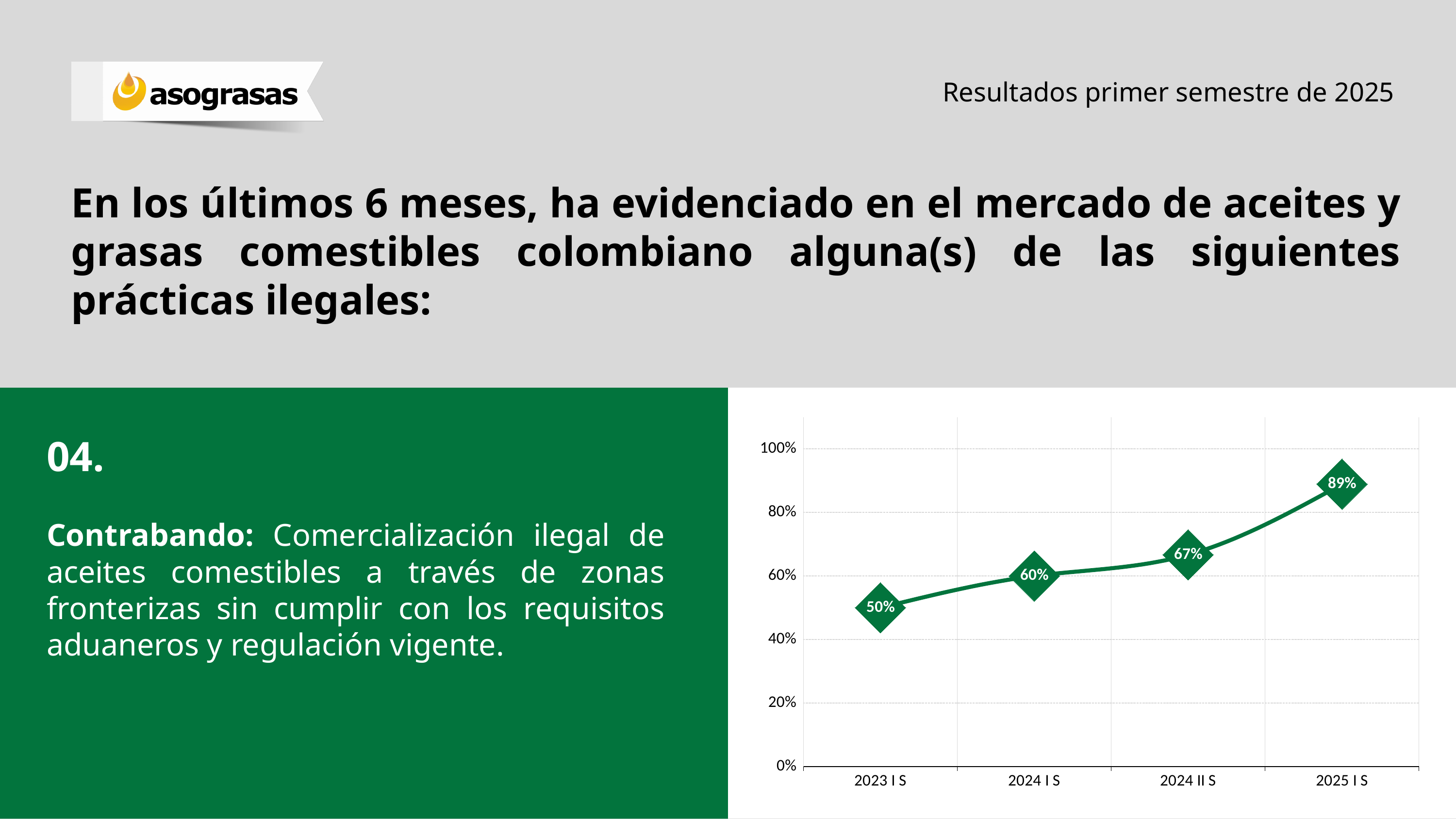
Which is larger, the value for 2024 II S or the value for 2024 I S? 2024 II S Do the values rise or fall from 2023 I S to 2025 I S? rise Which period has the highest value? 2025 I S How many data points are plotted on the chart? 4 Which period has the lowest value? 2023 I S What is the value for 2024 I S? 60% What is the difference between the values for 2024 I S and 2023 I S? 10% What is the difference between the values for 2025 I S and 2024 II S? 22% What kind of chart is shown on the slide? line chart What is the value for 2024 II S? 67% What is the value for 2025 I S? 89% What is the value for 2023 I S? 50%